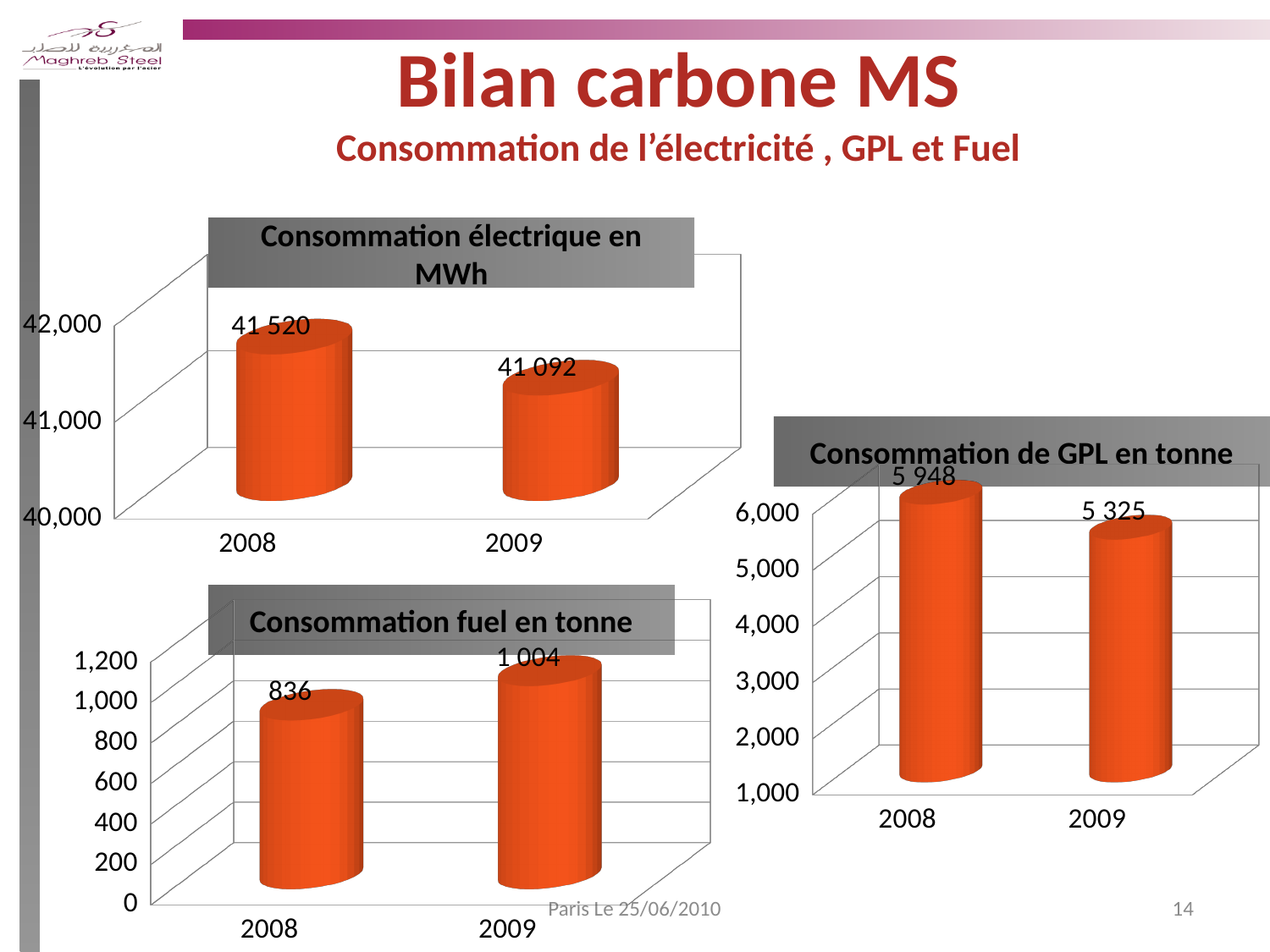
In the 'Consommation de GPL en tonne' chart, which year has the lower value? 2009 In the 'Consommation fuel en tonne' chart, what is the difference between the 2009 and 2008 values? 168 In the 'Consommation électrique en MWh' chart, what is the value for 2009? 41 092 In the 'Consommation électrique en MWh' chart, do the values rise or fall from 2008 to 2009? fall How many charts are shown on the slide? 3 In the 'Consommation fuel en tonne' chart, what is the value for 2009? 1 004 In the 'Consommation de GPL en tonne' chart, what is the value for 2008? 5 948 In the 'Consommation fuel en tonne' chart, which year has the higher value? 2009 In the 'Consommation électrique en MWh' chart, what is the difference between the 2008 and 2009 values? 428 In the 'Consommation de GPL en tonne' chart, what is the value for 2009? 5 325 In the 'Consommation électrique en MWh' chart, what is the value for 2008? 41 520 In the 'Consommation fuel en tonne' chart, what is the value for 2008? 836